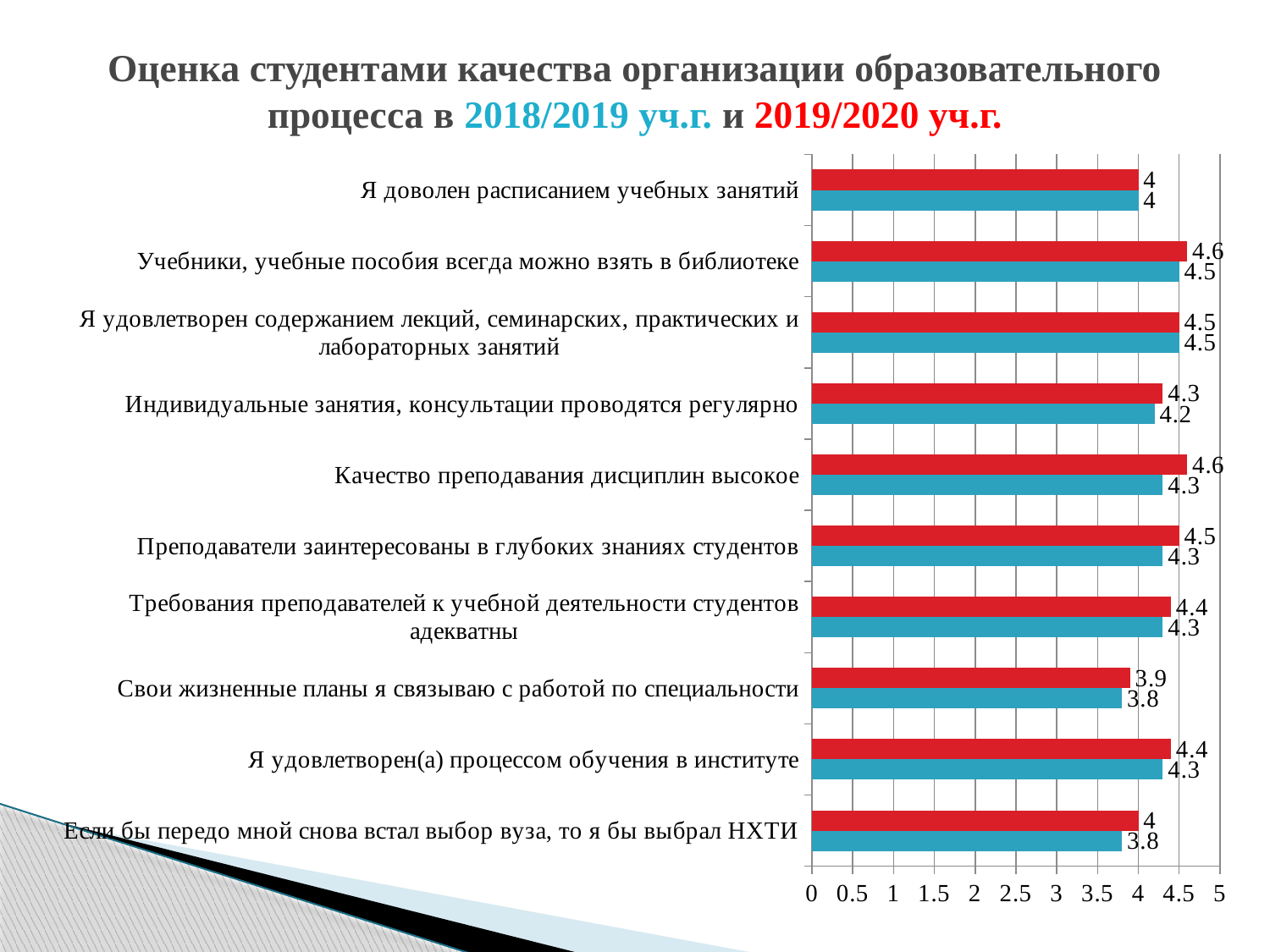
What is the difference between the red and blue bars for 'Если бы передо мной снова встал выбор вуза, то я бы выбрал НХТИ'? 0.2 Which is larger for 'Преподаватели заинтересованы в глубоких знаниях студентов': the red bar or the blue bar? the red bar What is the maximum value shown on the horizontal axis? 5 What is the difference between the red and blue bars for 'Качество преподавания дисциплин высокое'? 0.3 What type of chart is shown on the slide? bar chart Which category has the lowest value for the red bars? Свои жизненные планы я связываю с работой по специальности How many categories (statements) are shown in the chart? 10 What is the value of the blue bar for 'Индивидуальные занятия, консультации проводятся регулярно'? 4.2 What is the value of the blue bar for 'Свои жизненные планы я связываю с работой по специальности'? 3.8 What is the value of the red bar for 'Качество преподавания дисциплин высокое'? 4.6 What is the value of the red bar for 'Если бы передо мной снова встал выбор вуза, то я бы выбрал НХТИ'? 4 Is the blue bar for 'Учебники, учебные пособия всегда можно взять в библиотеке' greater or less than 4? greater